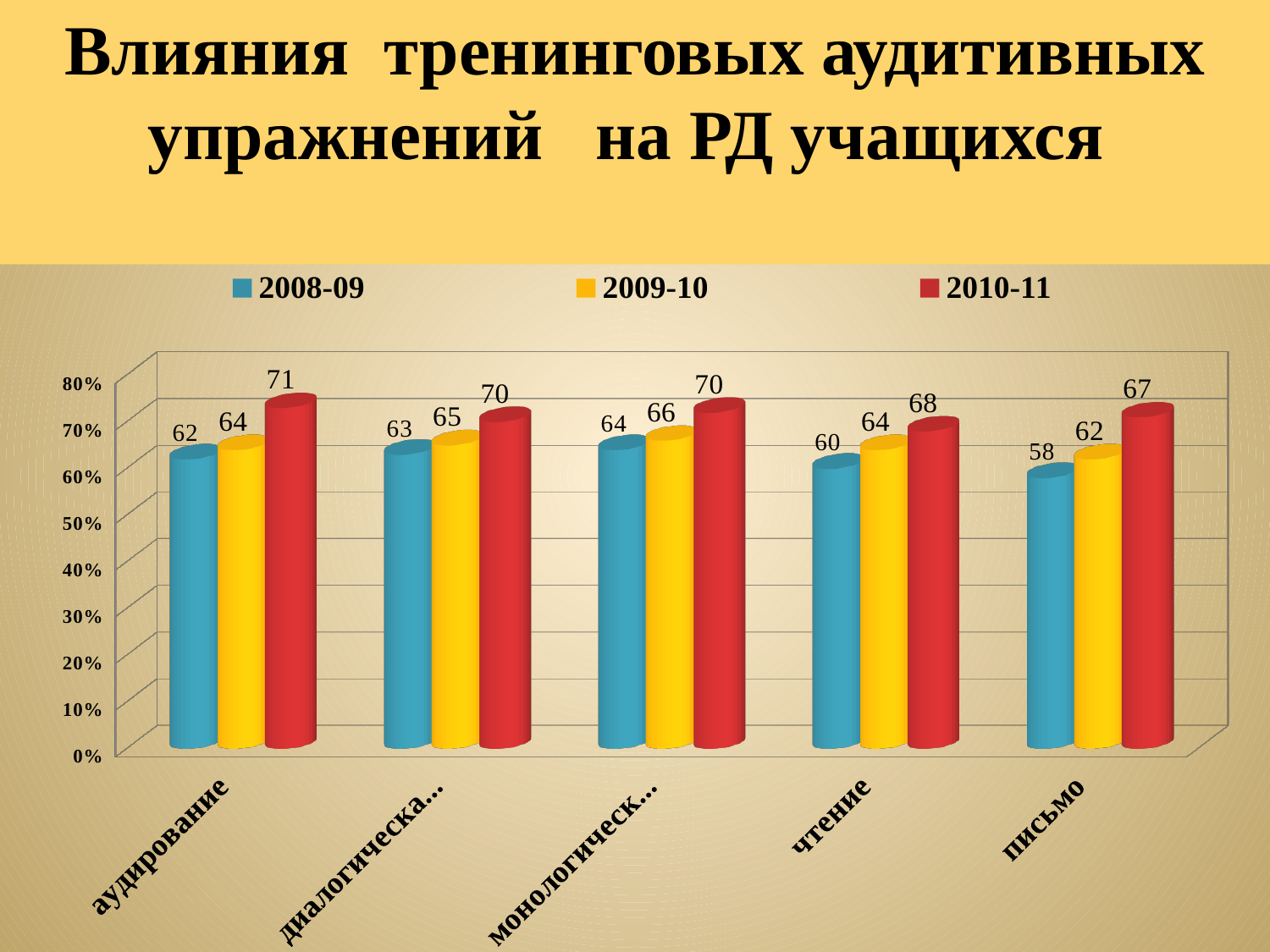
What is the value for аудирование in the 2010-11 series? 71 What is the value for чтение in the 2009-10 series? 64 In the 2008-09 series, which is larger: the value for чтение or the value for письмо? чтение Is the 2010-11 value for письмо greater or less than 60%? greater Which category has the highest value in the 2010-11 series? аудирование What kind of chart is shown on the slide? bar chart Which category has the lowest value in the 2008-09 series? письмо How many categories are shown on the x axis? 5 What is the difference between the 2010-11 and 2008-09 values for аудирование? 9 How many series does the legend list? 3 What is the value for письмо in the 2008-09 series? 58 For чтение, do the values rise or fall from 2008-09 to 2010-11? rise